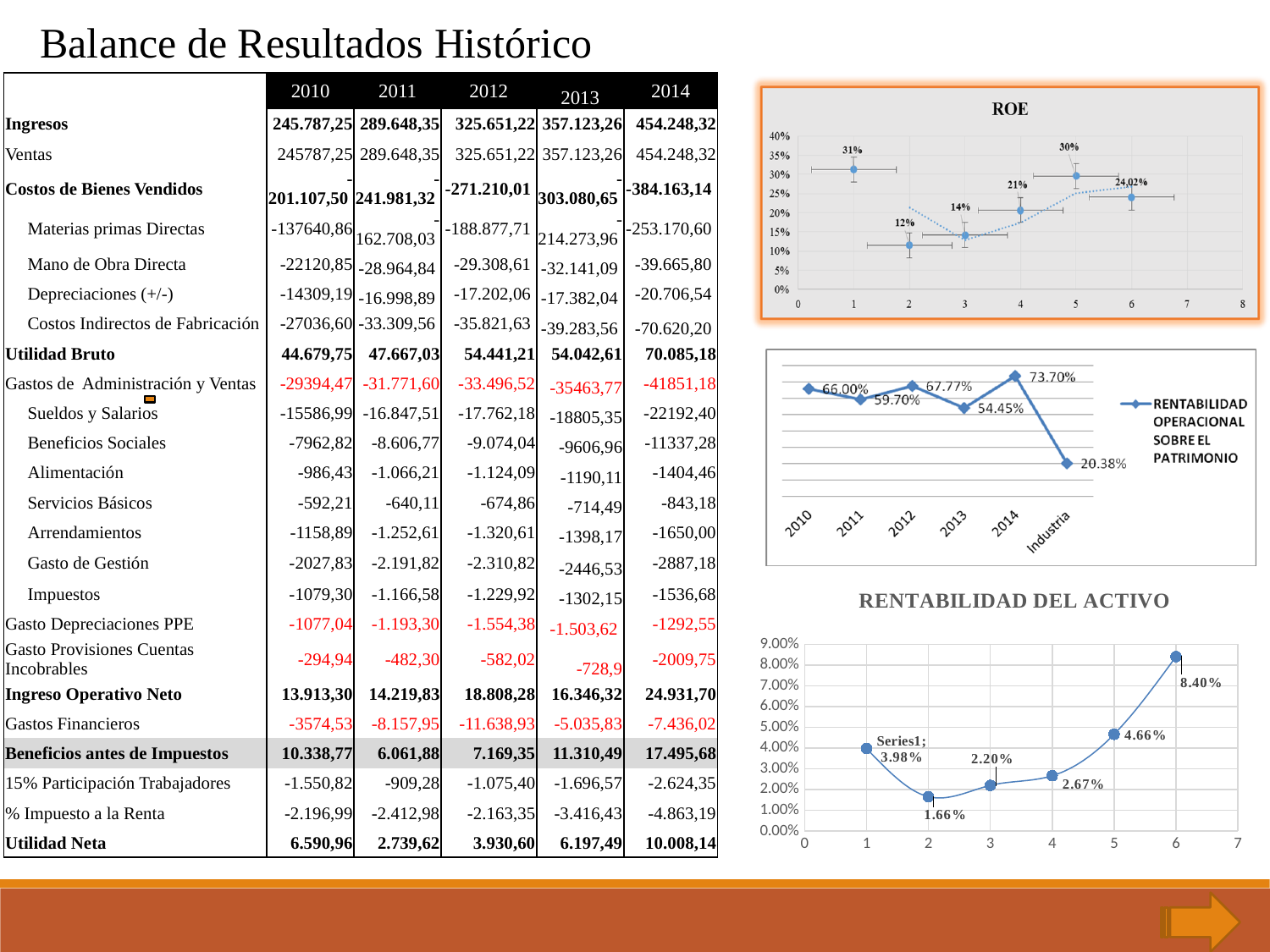
In the RENTABILIDAD DEL ACTIVO chart, what is the lowest value shown? 1.66% What kind of chart is the RENTABILIDAD DEL ACTIVO chart? line chart In the ROE chart, is the value at x = 2 greater or less than 20%? less In the ROE chart, what is the value at x = 1? 31% In the RENTABILIDAD OPERACIONAL SOBRE EL PATRIMONIO chart, what is the value for Industria? 20.38% In the RENTABILIDAD OPERACIONAL SOBRE EL PATRIMONIO chart, which category has the lowest value? Industria In the RENTABILIDAD DEL ACTIVO chart, what is the value at point 6? 8.40% In the RENTABILIDAD DEL ACTIVO chart, what is the difference between the values at point 5 and point 4? 1.99% In the RENTABILIDAD OPERACIONAL SOBRE EL PATRIMONIO chart, what is the value for 2014? 73.70% In the RENTABILIDAD OPERACIONAL SOBRE EL PATRIMONIO chart, which year has the highest value? 2014 In the RENTABILIDAD OPERACIONAL SOBRE EL PATRIMONIO chart, is the value for 2012 larger or smaller than the value for 2013? larger In the RENTABILIDAD OPERACIONAL SOBRE EL PATRIMONIO chart, how many categories are shown on the x axis? 6